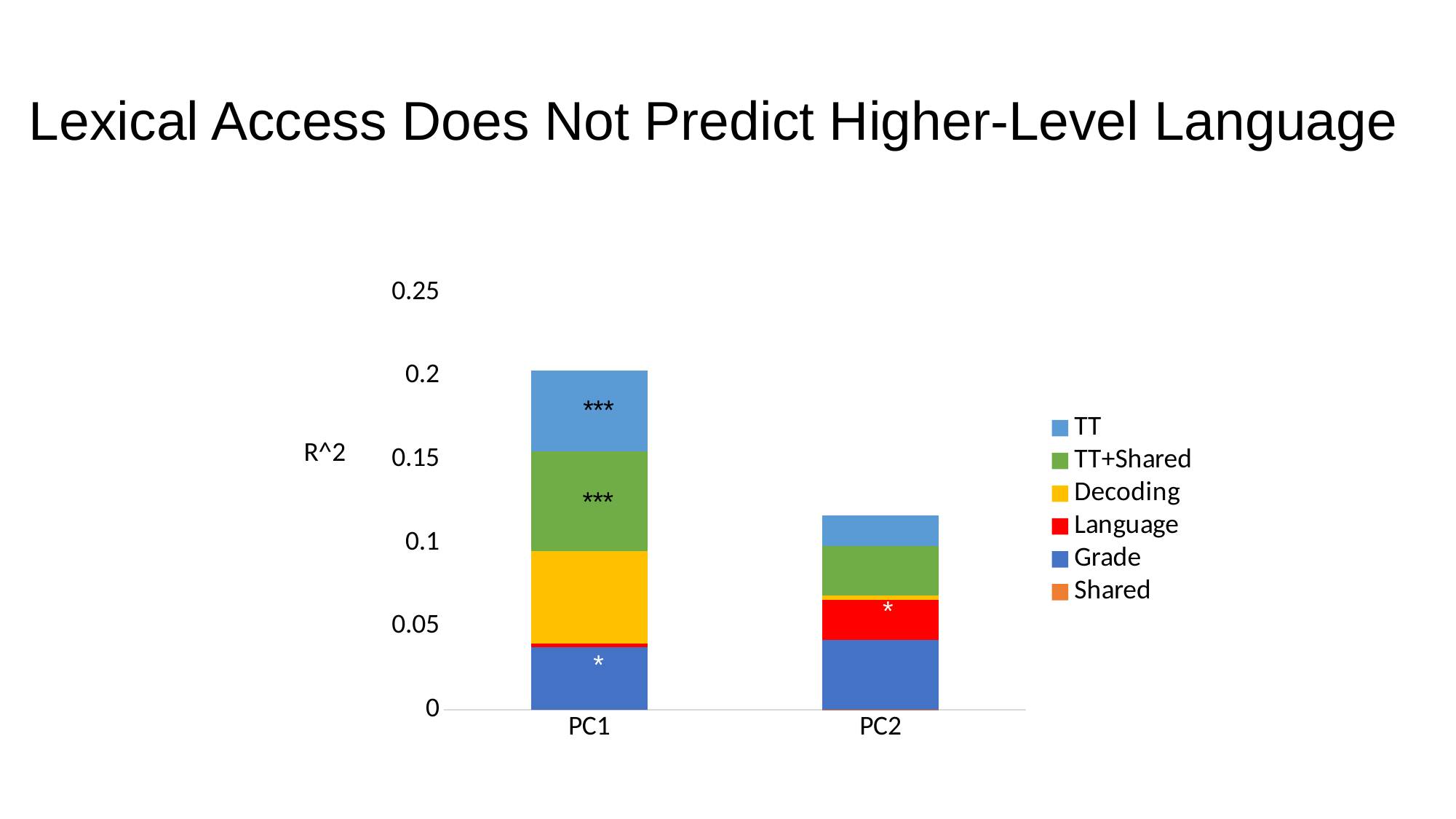
Is the Language segment larger in the PC1 bar or the PC2 bar? PC2 What kind of chart is shown on the slide? Stacked bar chart How many categories are shown on the x axis of the chart? 2 How many series does the chart's legend list? 6 Which category has the shorter stacked bar, PC1 or PC2? PC2 What is the label on the y axis of the chart? R^2 Is the total height of the PC2 bar greater or less than 0.1? greater Which category has the taller stacked bar, PC1 or PC2? PC1 Is the Decoding segment larger in the PC1 bar or the PC2 bar? PC1 Is the Grade segment of the PC2 bar greater or less than 0.05? less Is the total height of the PC2 bar greater or less than 0.15? less